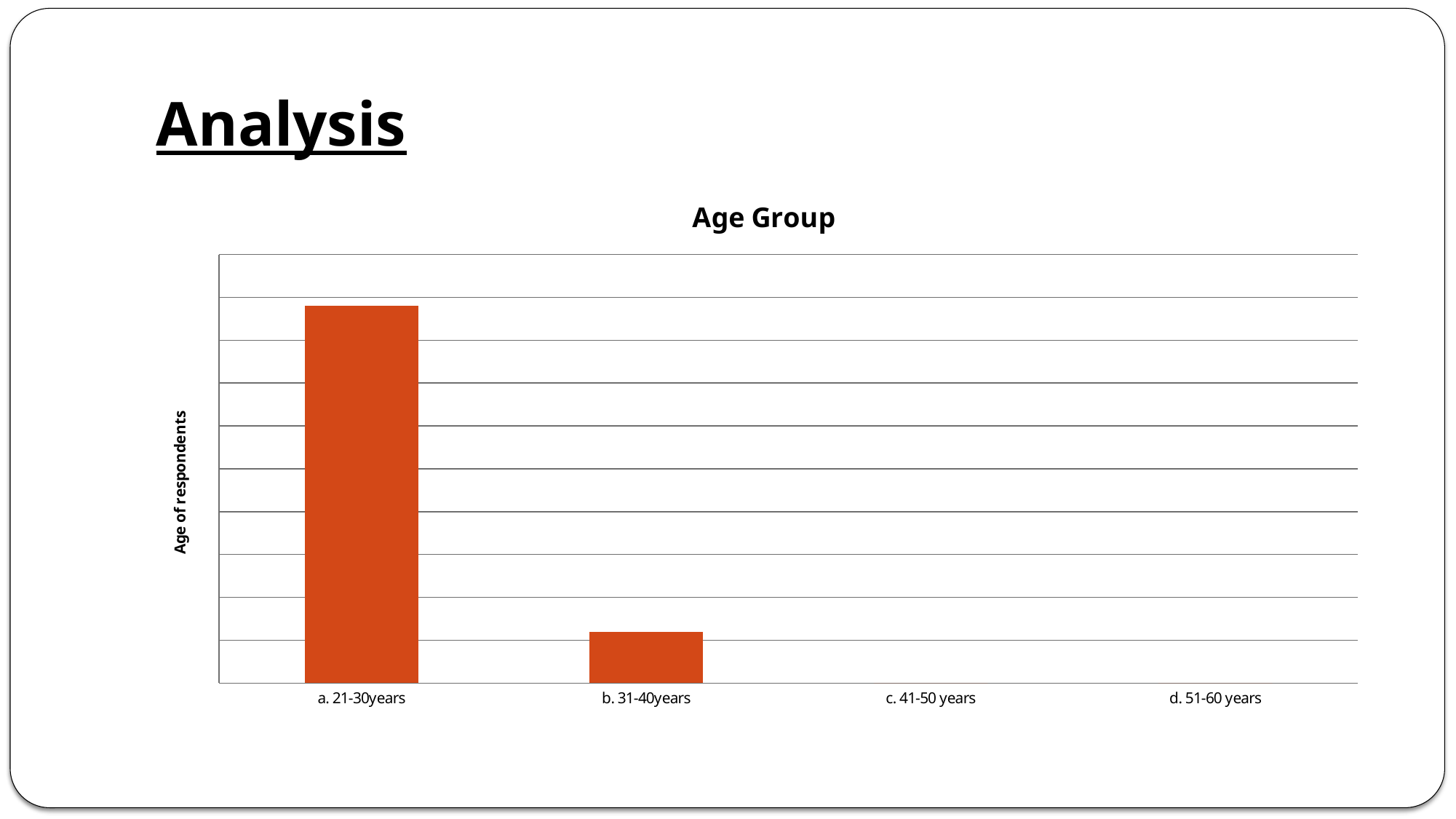
What is the label on the vertical axis of the chart? Age of respondents Which age group has the highest value? a. 21-30years What type of chart is shown on the slide? Bar chart Do the values rise or fall moving from left to right along the x axis? Fall How many categories have a visible bar in the chart? 2 Which age groups show no visible bar in the chart? c. 41-50 years and d. 51-60 years How many age group categories are shown on the x axis? 4 Which is larger, the value for b. 31-40years or c. 41-50 years? b. 31-40years Which is larger, the value for a. 21-30years or b. 31-40years? a. 21-30years What is the title of the chart? Age Group